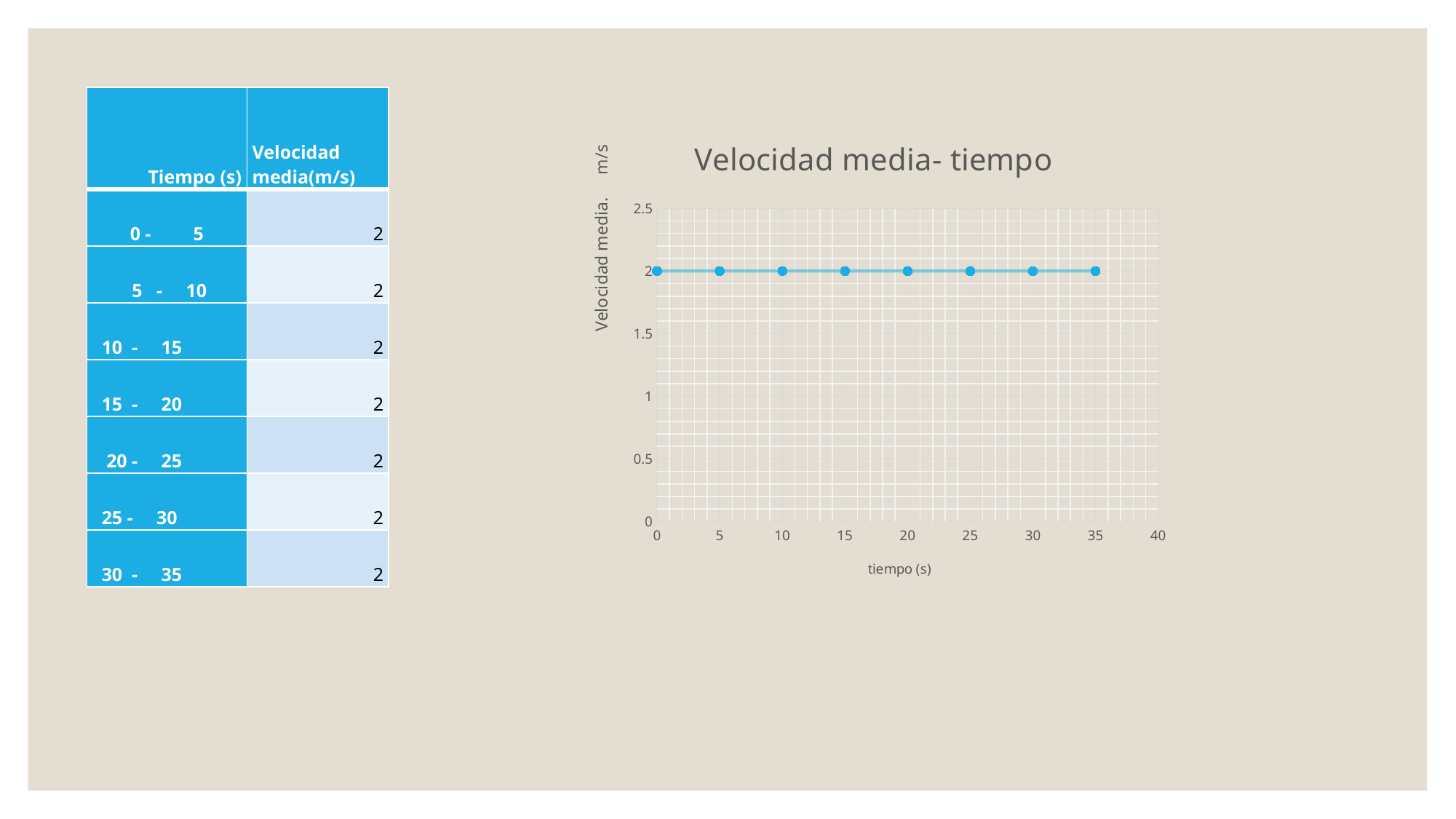
Do the plotted values rise, fall, or stay constant as tiempo increases from 0 to 35 s? stay constant What is the difference between the value at tiempo 5 s and the value at tiempo 25 s? 0 How many data points are plotted on the chart? 8 Is the value at tiempo 30 s greater or less than 2.5? less Is the value at tiempo 15 s greater or less than 1.5? greater What is the value of velocidad media at tiempo 0 s? 2 What is the value of velocidad media at tiempo 20 s? 2 What is the value of velocidad media at tiempo 35 s? 2 What is the highest value shown on the y axis? 2.5 What kind of chart is shown on the slide? line chart What is the title of the chart? Velocidad media- tiempo What is the label of the x axis? tiempo (s)